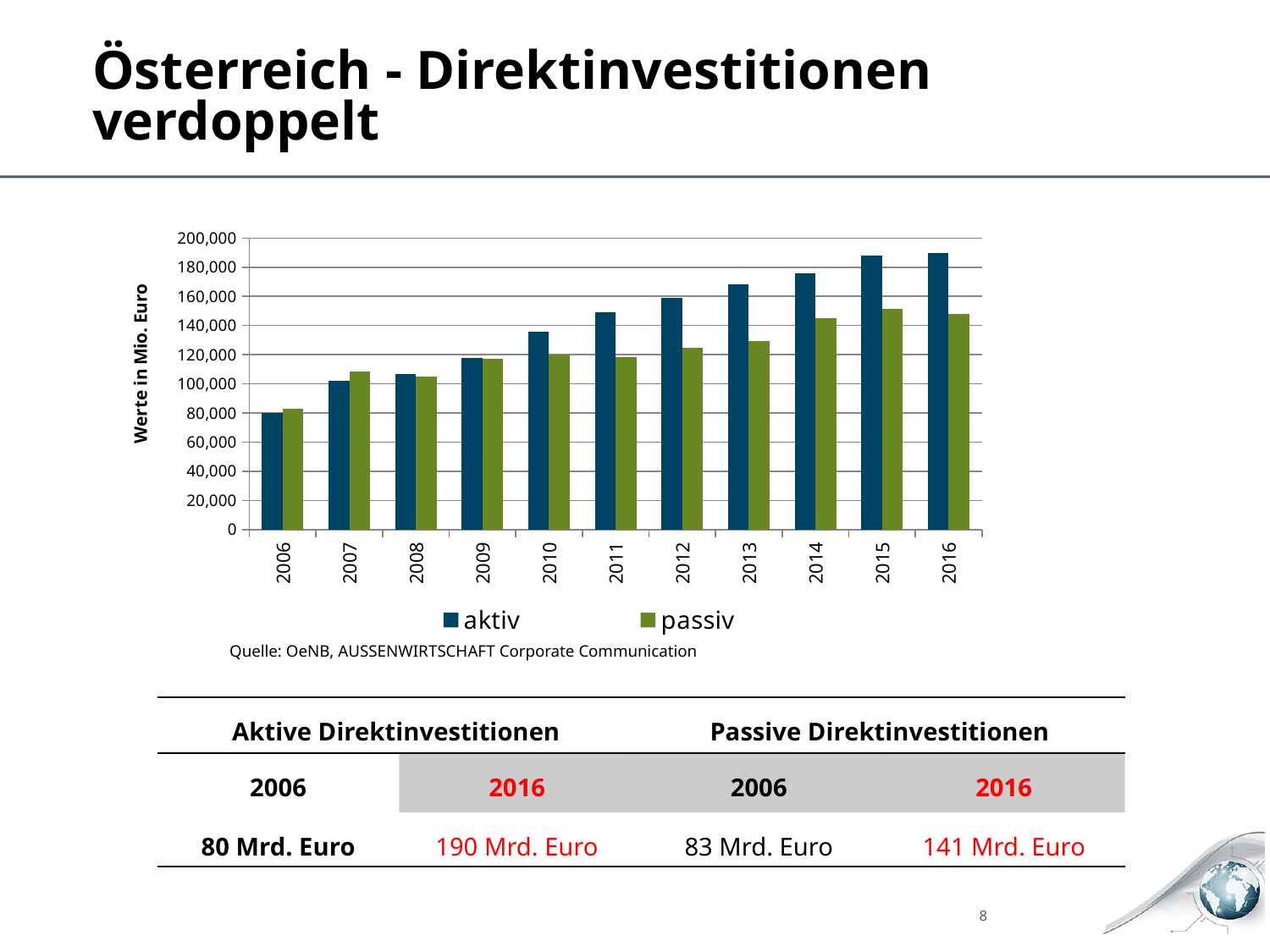
Is the passiv value for 2010 greater or less than 140,000? less Which year has the lowest value for the aktiv series? 2006 Which year has the lowest value for the passiv series? 2006 How many years are shown on the x axis of the chart? 11 Is the aktiv value for 2006 greater or less than 100,000? less What is the label on the chart's y axis? Werte in Mio. Euro Is the aktiv value for 2014 greater or less than 160,000? greater Does the aktiv series generally rise or fall from 2006 to 2016? rise What kind of chart is shown on the slide? bar chart In 2016, which series has the larger value, aktiv or passiv? aktiv How many series does the chart's legend list? 2